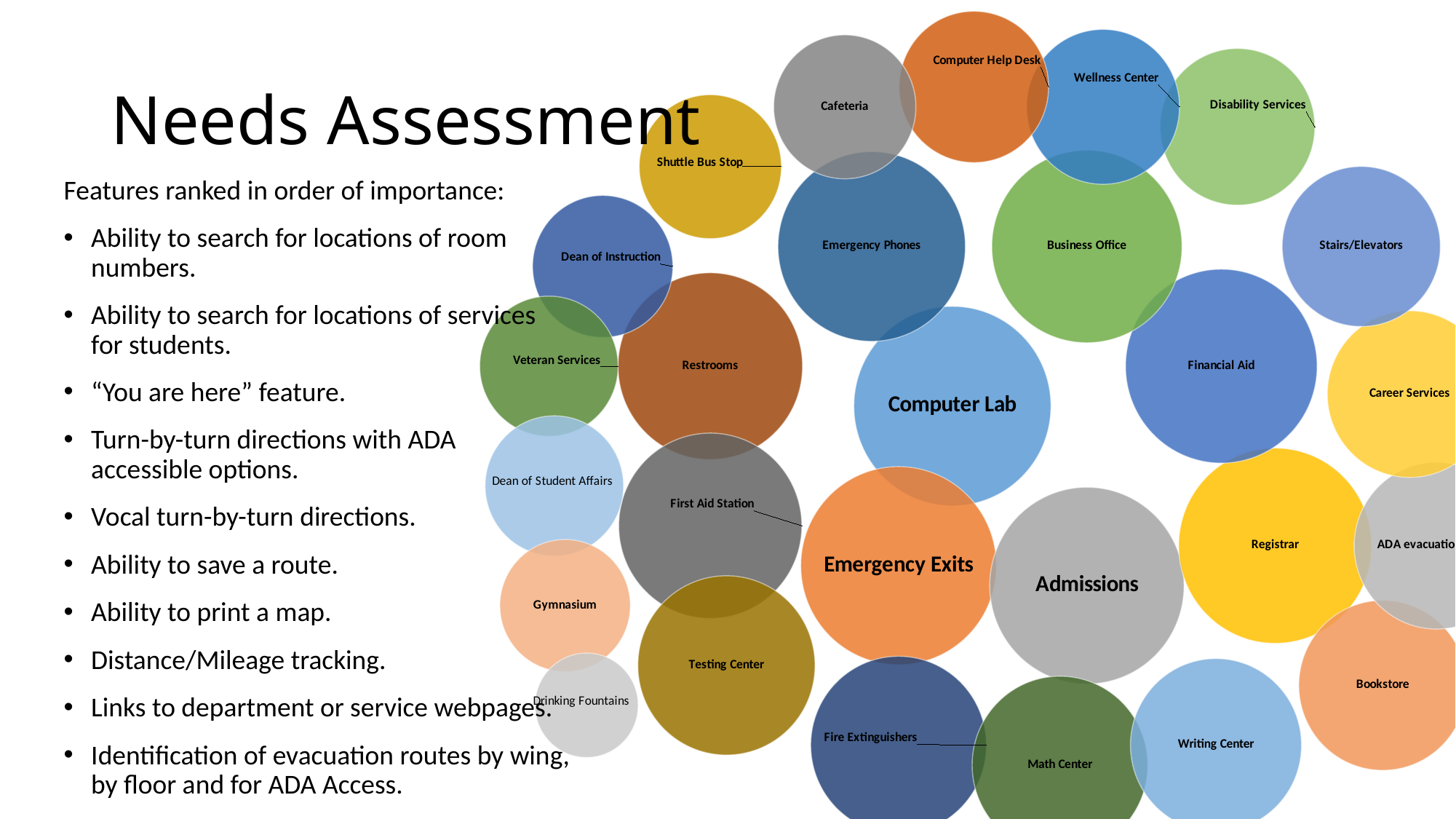
What colour is the Registrar bubble? yellow Which bubble is larger, Admissions or Veteran Services? Admissions Which bubble is larger, Computer Lab or Drinking Fountains? Computer Lab Which bubble is larger, Financial Aid or Career Services? Financial Aid Which category has the smallest bubble in the chart? Drinking Fountains How many bubbles (categories) are plotted in the chart? 27 What kind of chart is shown on the slide? bubble chart What colour is the Emergency Exits bubble? orange